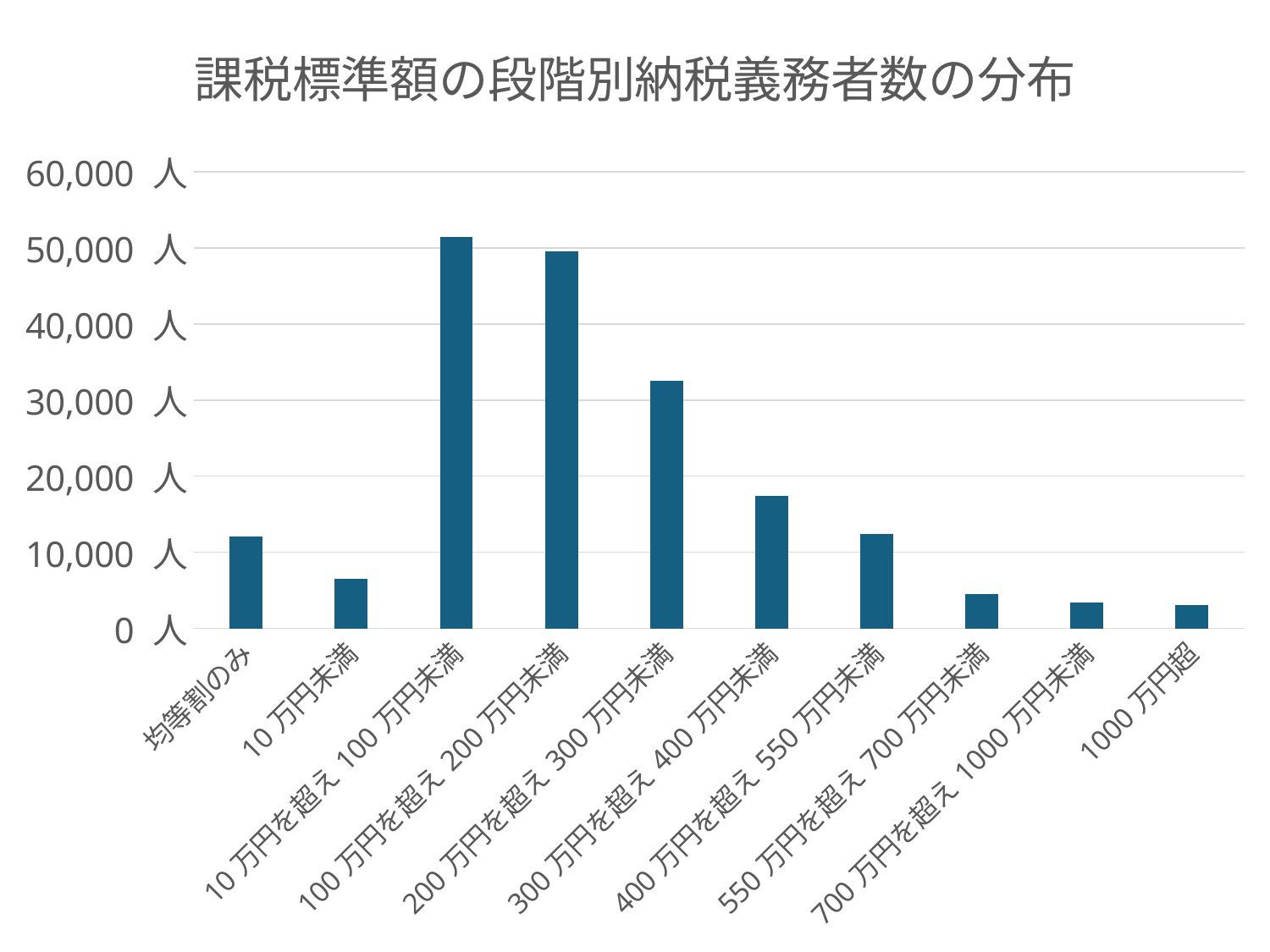
What kind of chart is shown on the slide? bar chart Is the value for 550 万円を超え 700 万円未満 greater or less than 10,000 人? less Is the value for 300 万円を超え 400 万円未満 greater or less than 20,000 人? less Is the value for 均等割のみ greater or less than 10,000 人? greater Which is larger, the value for 200 万円を超え 300 万円未満 or the value for 300 万円を超え 400 万円未満? 200 万円を超え 300 万円未満 What is the title of the chart? 課税標準額の段階別納税義務者数の分布 From 10 万円を超え 100 万円未満 onward, do the values rise or fall along the x axis? fall Which is larger, the value for 均等割のみ or the value for 10 万円未満? 均等割のみ Which category has the highest number of taxpayers? 10 万円を超え 100 万円未満 How many categories are shown on the x axis? 10